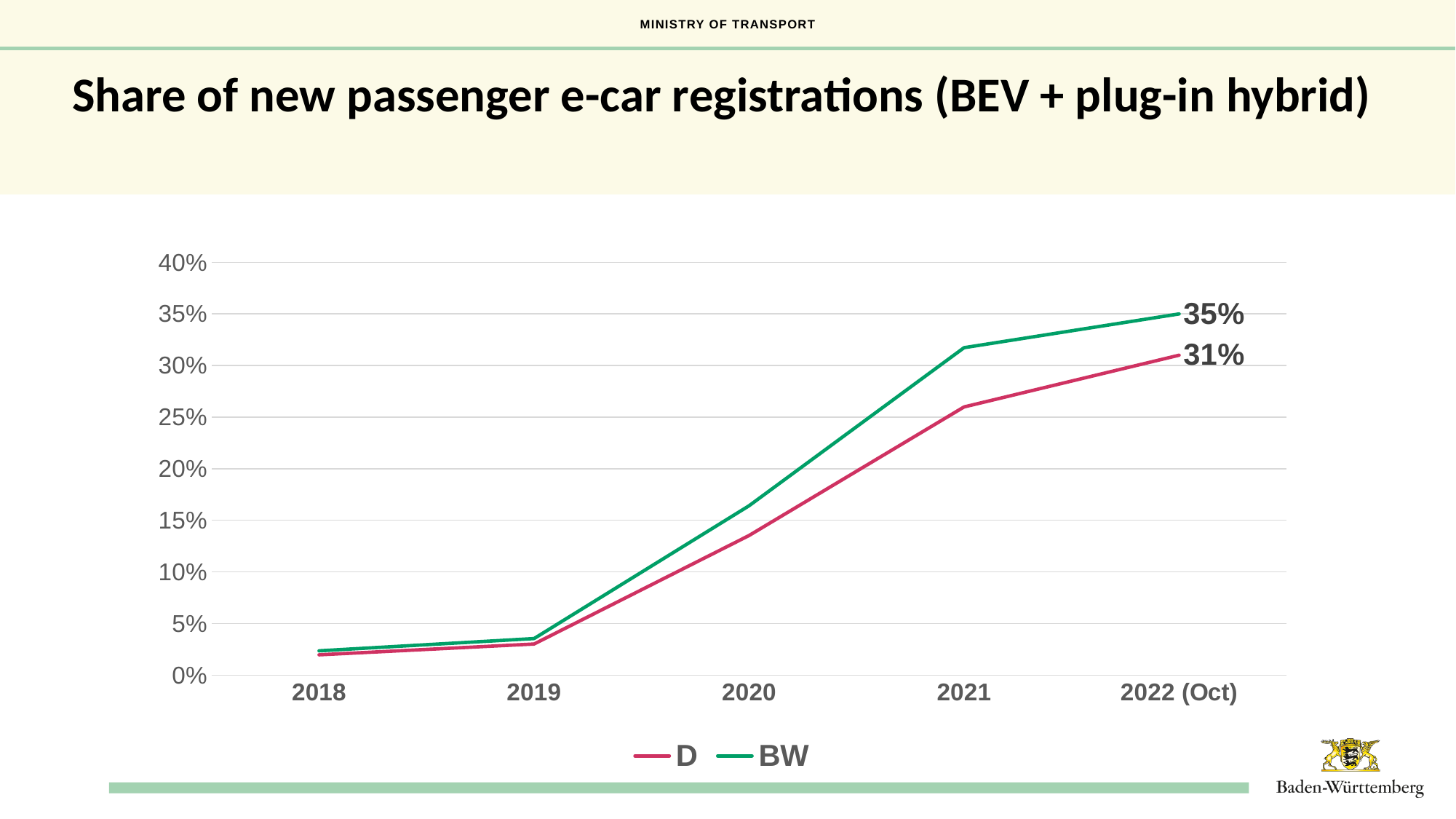
What is the value for BW in 2022 (Oct)? 35% What is the difference between the BW and D values in 2022 (Oct)? 4% How many years are shown on the x axis? 5 What kind of chart is shown on the slide? Line chart Is the value for D in 2020 greater or less than 15%? less What is the value for D in 2022 (Oct)? 31% Is the value for BW in 2021 greater or less than 30%? greater Which series has the higher value in 2022 (Oct), D or BW? BW Do the values for BW rise or fall from 2018 to 2022 (Oct)? Rise What colour is the line for BW? Green Is the value for D in 2018 greater or less than 5%? less How many series does the legend list? 2